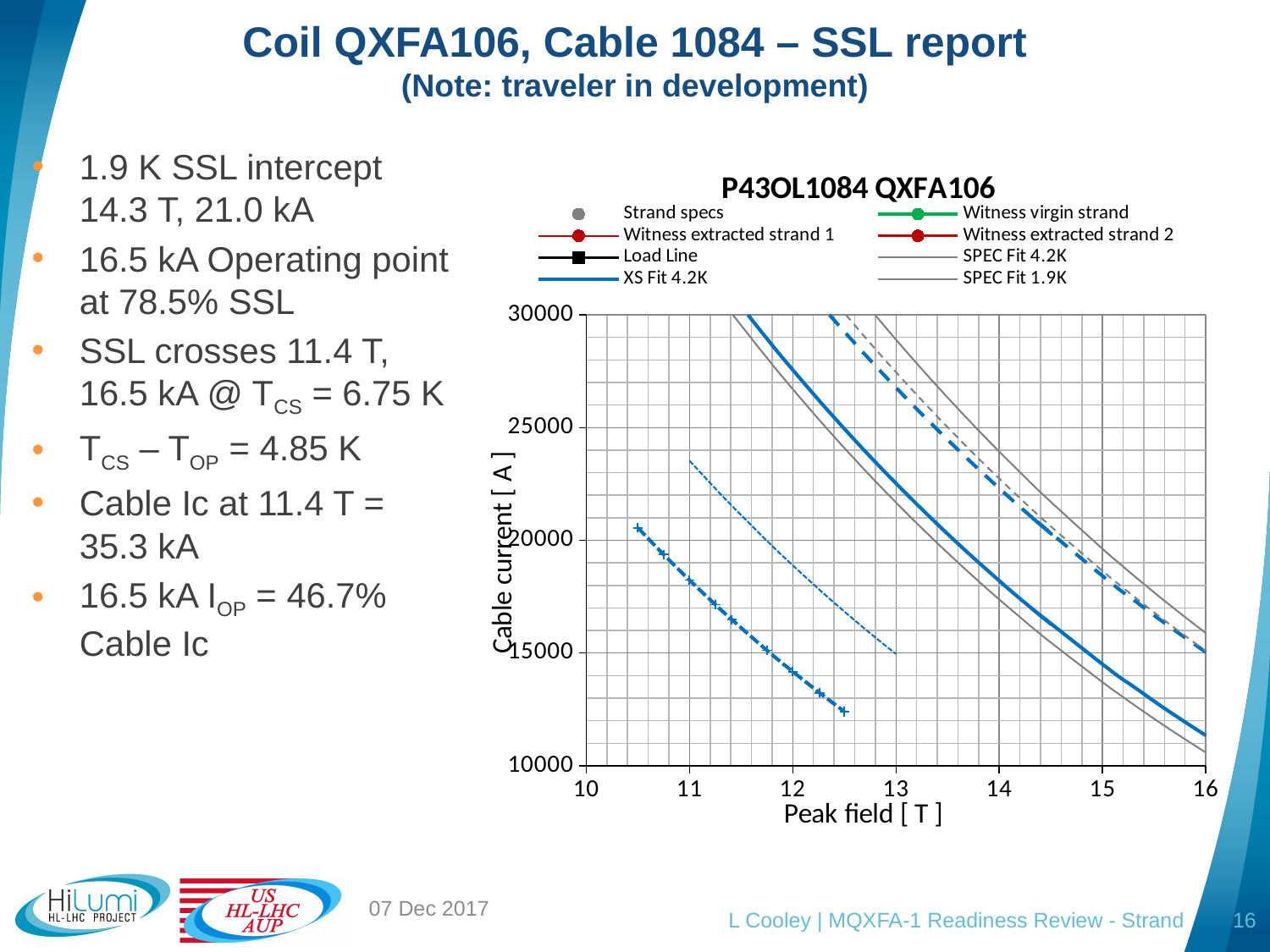
How many series does the chart legend list? 8 What kind of chart is shown on the slide? line chart Do the fit curves in the chart rise or fall as peak field increases? fall Is the XS Fit 4.2K value at 16 T greater or less than 15000? less What is the title of the chart? P43OL1084 QXFA106 Is the XS Fit 4.2K value at 14 T greater or less than 20000? less What is the maximum value shown on the y axis of the chart? 30000 What is the label of the x axis of the chart? Peak field [ T ] At 14 T, which is larger: the SPEC Fit 1.9K curve or the XS Fit 4.2K curve? SPEC Fit 1.9K